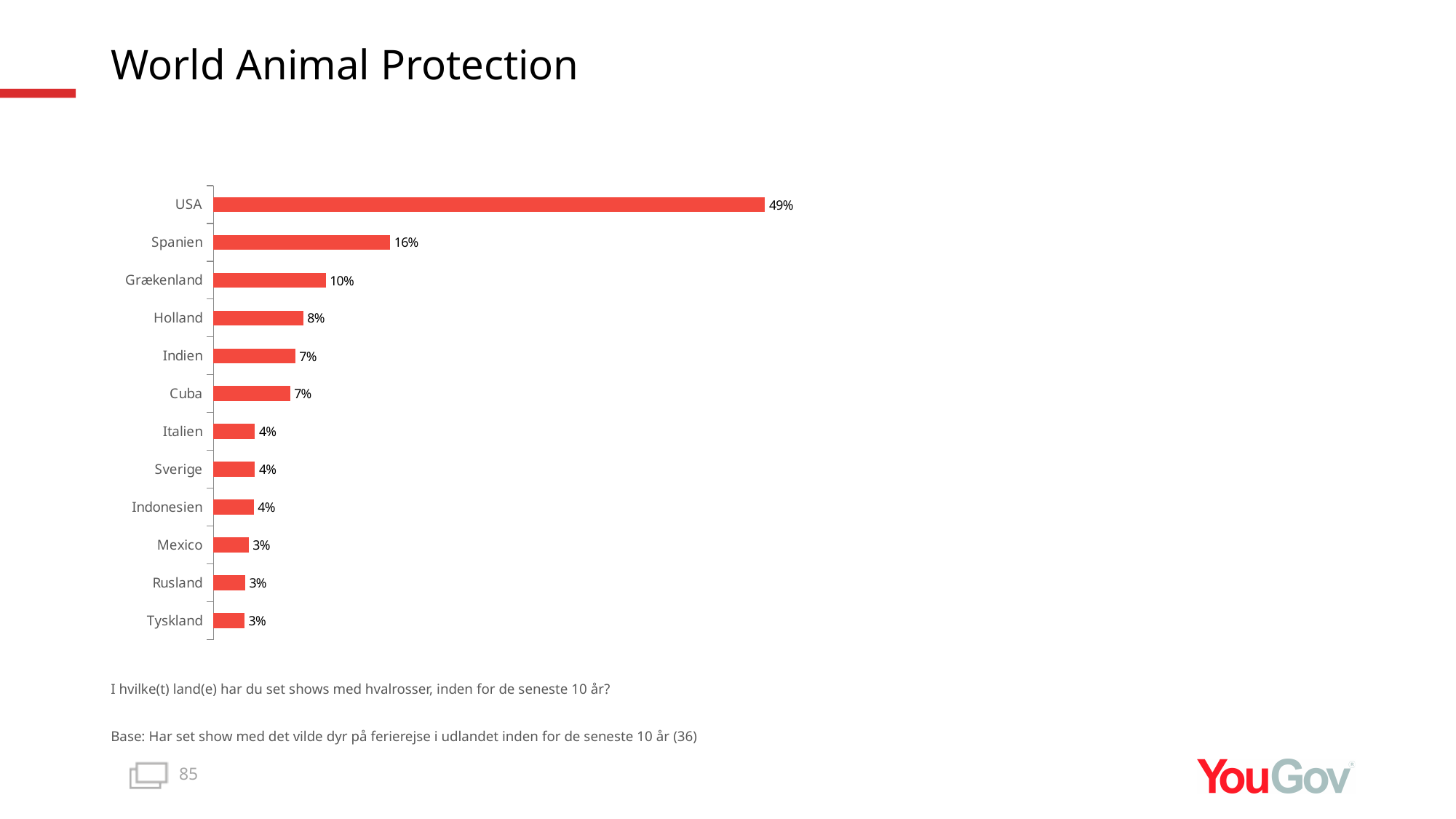
What is the value for Spanien? 16% What is the value for Grækenland? 10% Which is larger, the value for Indien or the value for Italien? Indien How many countries are shown in the chart? 12 What is the value for Holland? 8% Which country has the highest value? USA What is the difference between the values for Grækenland and Holland? 2% What kind of chart is shown on the slide? Bar chart What is the difference between the values for USA and Spanien? 33% What is the title of the slide? World Animal Protection Which is larger, the value for Spanien or the value for Grækenland? Spanien What is the value for USA? 49%